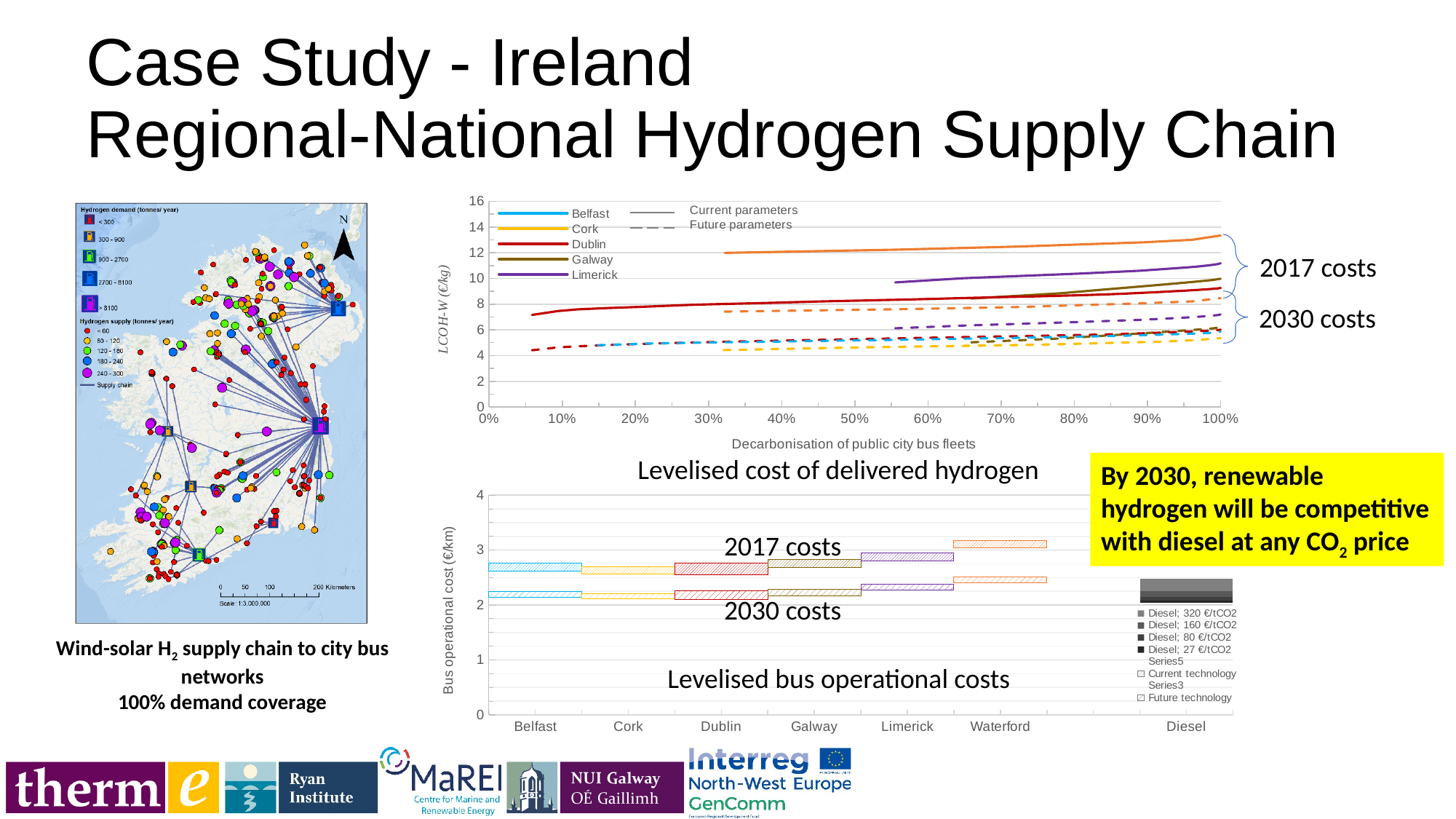
In the 'Levelised cost of delivered hydrogen' chart, do the 2017 cost lines rise or fall as decarbonisation increases? rise What kind of chart is the 'Levelised cost of delivered hydrogen' chart? line chart In the 'Levelised bus operational costs' chart, which is larger, the 2017 cost for Limerick or the 2017 cost for Cork? Limerick In the 'Levelised cost of delivered hydrogen' chart, is the 2017 cost for Limerick at 100% decarbonisation greater or less than 10? greater In the 'Levelised cost of delivered hydrogen' chart, is the 2030 cost for Cork at 100% decarbonisation greater or less than 6? less What kind of chart is the 'Levelised bus operational costs' chart? bar chart In the 'Levelised cost of delivered hydrogen' chart, how many cities does the legend list? 5 In the 'Levelised cost of delivered hydrogen' chart, is the 2017 cost for Dublin at 100% decarbonisation greater or less than 10? less In the 'Levelised bus operational costs' chart, how many categories are shown on the x axis? 7 In the 'Levelised cost of delivered hydrogen' chart, what is the label of the x axis? Decarbonisation of public city bus fleets In the 'Levelised bus operational costs' chart, which city has the highest 2017 cost? Waterford